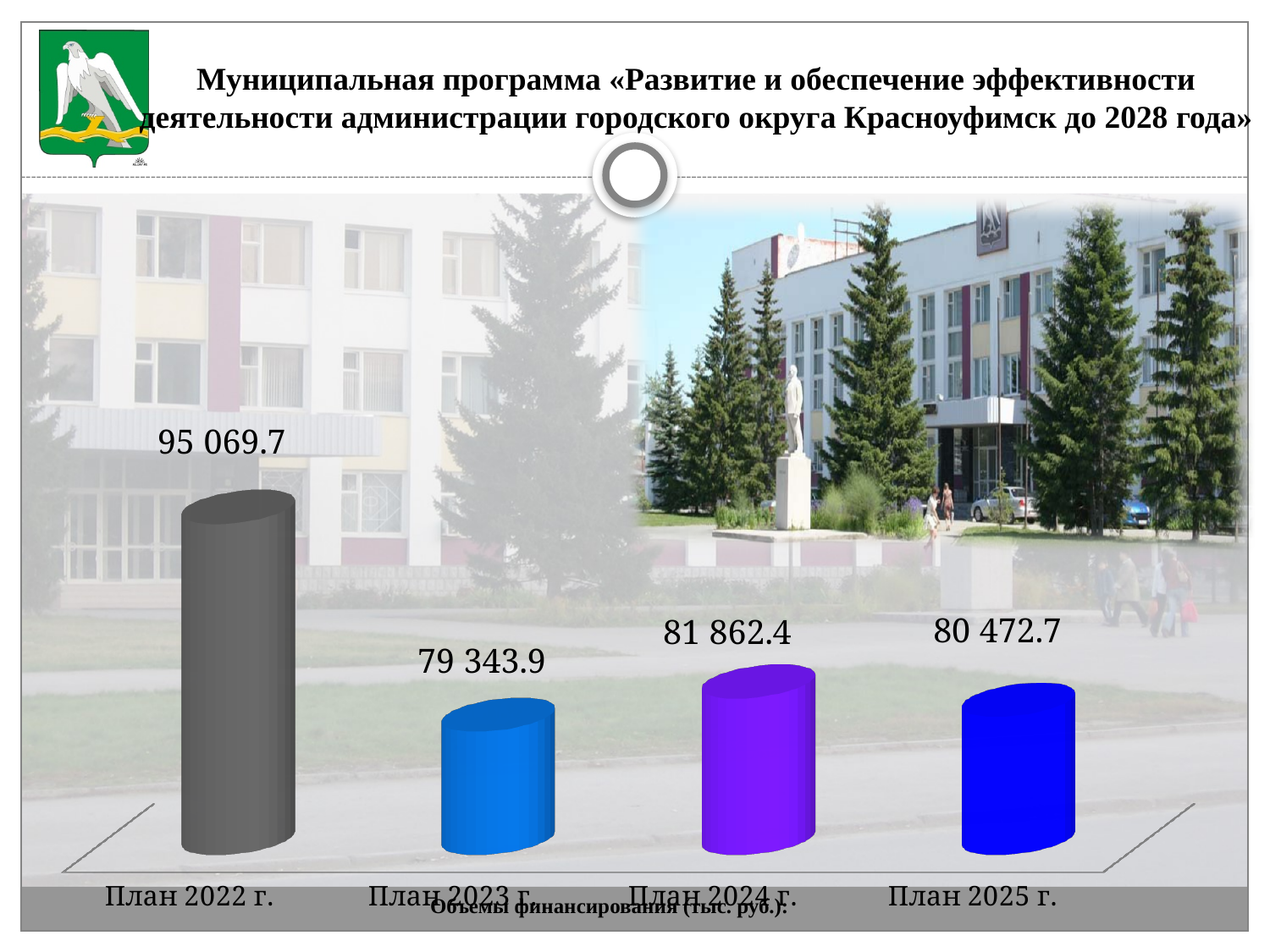
What is the value for План 2025 г.? 80 472.7 How many categories are shown in the chart? 4 What is the axis title shown below the categories? Объемы финансирования (тыс. руб.): Which category has the highest value? План 2022 г. What is the difference between the values for План 2024 г. and План 2025 г.? 1 389.7 What kind of chart is shown on the slide? Bar chart What is the value for План 2024 г.? 81 862.4 What is the value for План 2022 г.? 95 069.7 What is the value for План 2023 г.? 79 343.9 What is the difference between the values for План 2022 г. and План 2023 г.? 15 725.8 Which category has the lowest value? План 2023 г. Which is larger, the value for План 2024 г. or the value for План 2025 г.? План 2024 г.